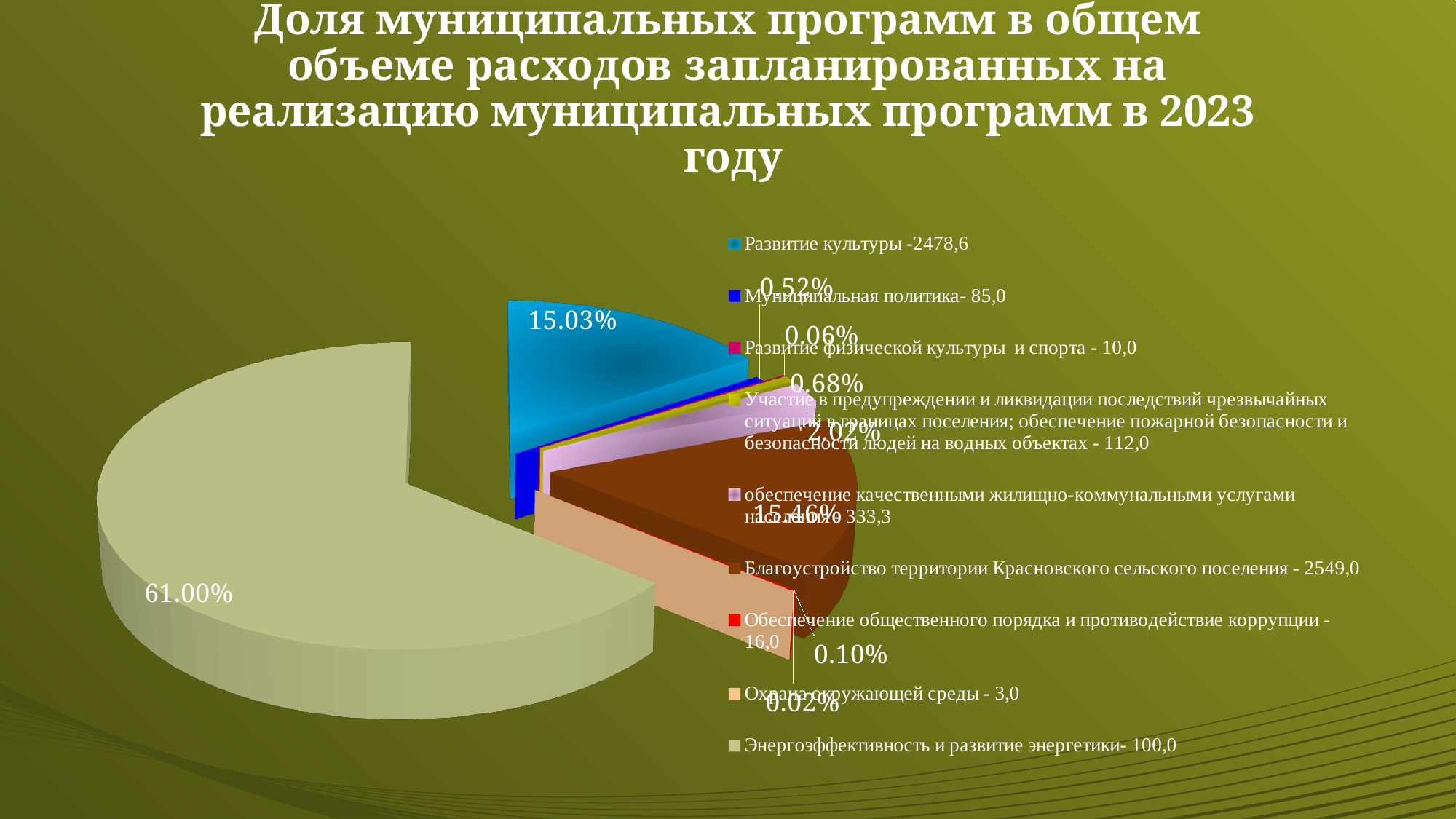
How many categories does the legend of the pie chart list? 9 What kind of chart is shown on the slide? pie chart What percentage label is shown for the lavender slice (обеспечение качественными жилищно-коммунальными услугами населения)? 2.02% Which year does the chart title refer to? 2023 What percentage label is shown on the brown slice (Благоустройство территории Красновского сельского поселения)? 15.46% What percentage label is shown on the cyan slice (Развитие культуры)? 15.03% What amount is given in the legend for Муниципальная политика? 85,0 Which category has the largest slice in the pie chart? Энергоэффективность и развитие энергетики- 100,0 What is the smallest percentage label shown on the pie chart? 0.02% What is the difference in percentage points between the 61.00% slice and the 15.46% slice? 45.54 What percentage is shown for the largest slice of the pie chart? 61.00% Which slice is larger: the brown slice labelled 15.46% or the cyan slice labelled 15.03%? the brown slice (15.46%)